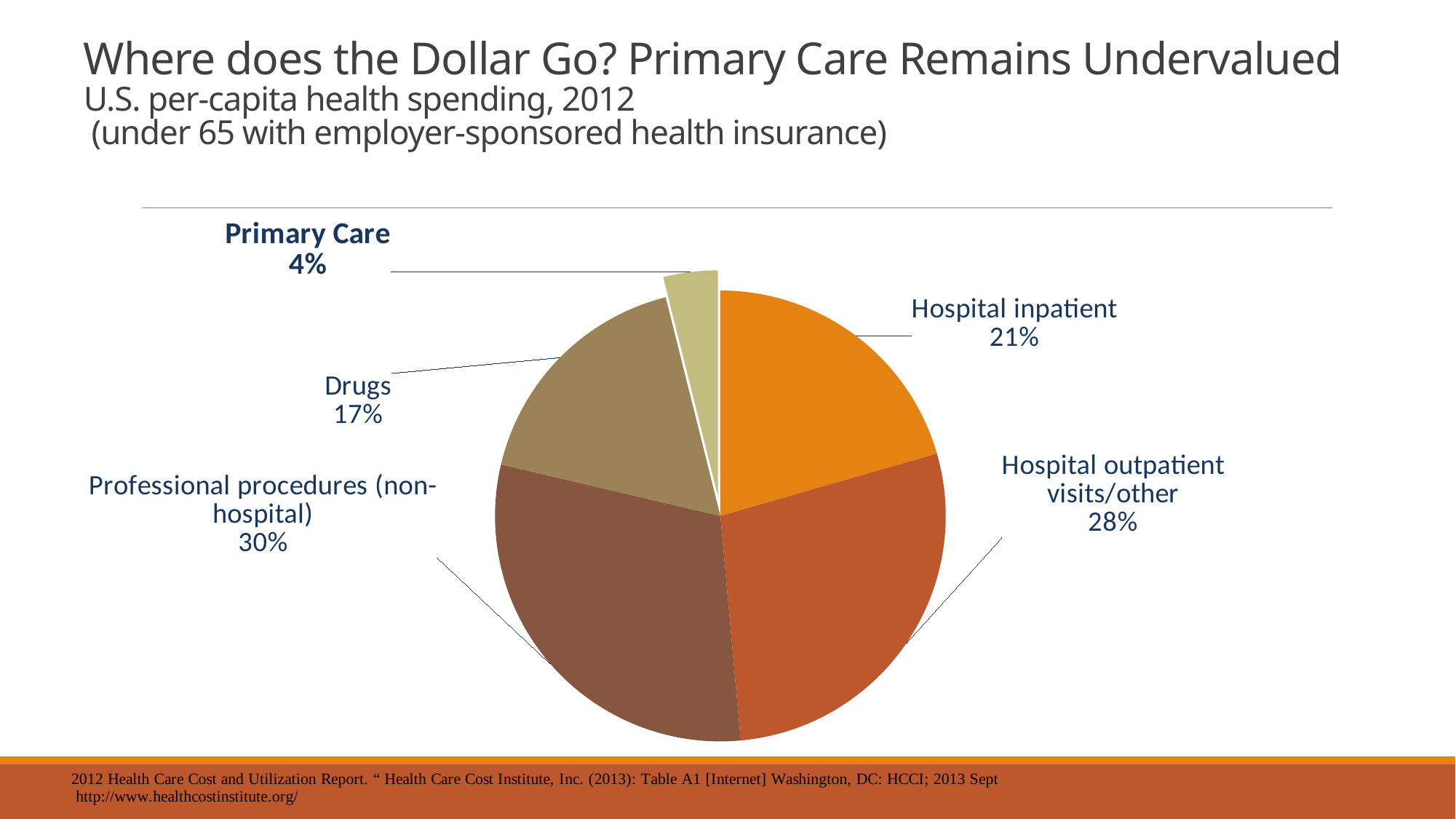
What share of spending goes to Hospital outpatient visits/other? 28% What share of spending goes to Primary Care? 4% Which slice is pulled out (exploded) from the pie? Primary Care What share of spending goes to Professional procedures (non-hospital)? 30% What share of spending goes to Hospital inpatient? 21% Which category has the smallest share of spending? Primary Care How many categories are shown in the pie chart? 5 What share of spending goes to Drugs? 17% What kind of chart is shown on the slide? Pie chart Which category has the largest share of spending? Professional procedures (non-hospital) What is the difference in percentage points between Hospital outpatient visits/other and Hospital inpatient? 7 Which is larger, the share for Drugs or the share for Hospital inpatient? Hospital inpatient